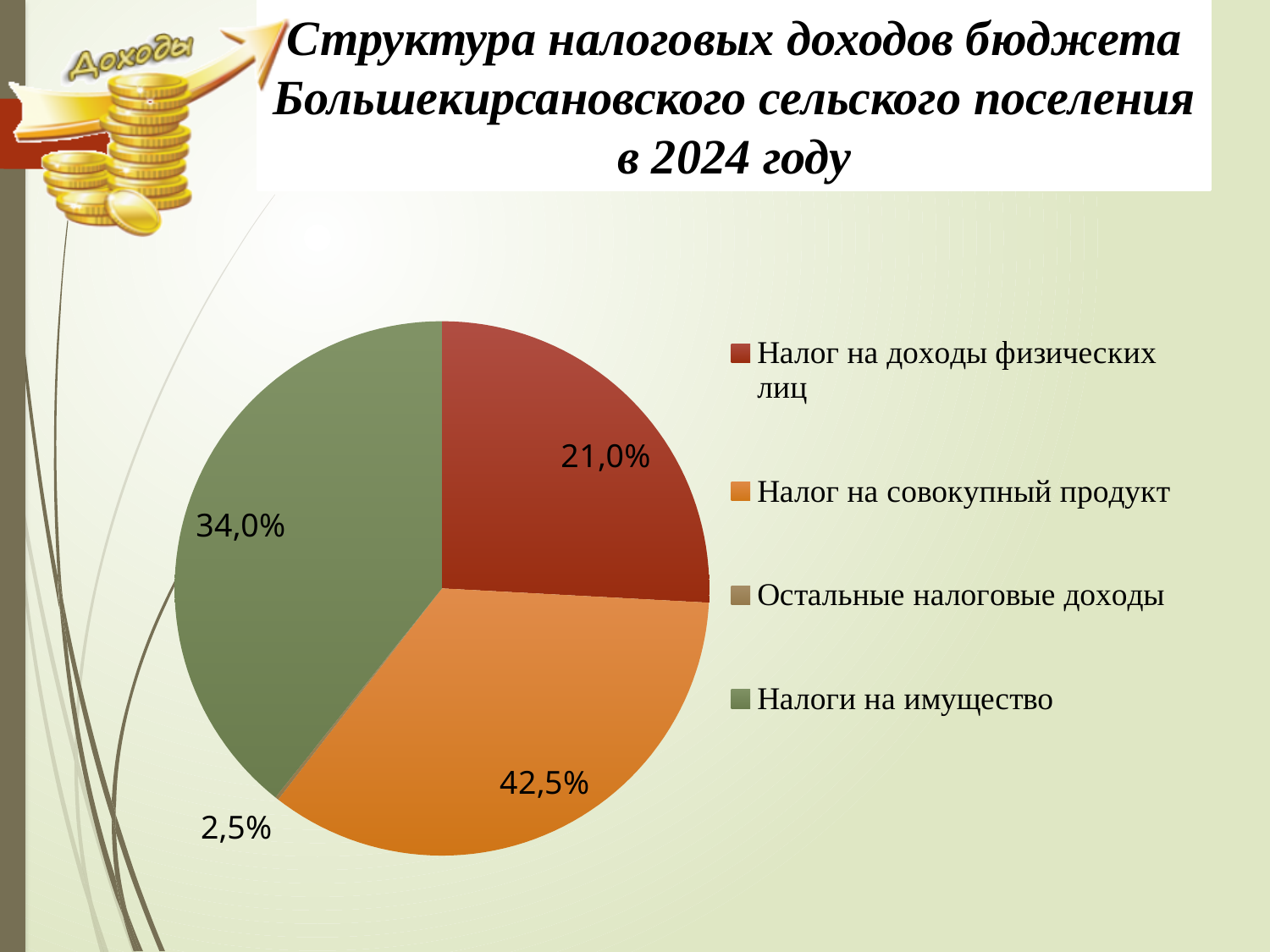
What share of tax revenues does "Остальные налоговые доходы" account for? 2,5% Which is larger: the share for "Налоги на имущество" or the share for "Налог на доходы физических лиц"? Налоги на имущество What share of tax revenues does "Налог на совокупный продукт" account for? 42,5% What share of tax revenues does "Налоги на имущество" account for? 34,0% What kind of chart is shown on the slide? pie chart Which category has the largest share of the pie? Налог на совокупный продукт Which category has the smallest share of the pie? Остальные налоговые доходы What colour is the slice for "Налог на совокупный продукт"? orange What is the difference in percentage points between "Налог на доходы физических лиц" and "Остальные налоговые доходы"? 18,5 How many categories does the pie chart show? 4 What is the difference in percentage points between "Налог на совокупный продукт" and "Налоги на имущество"? 8,5 What share of tax revenues does "Налог на доходы физических лиц" account for? 21,0%